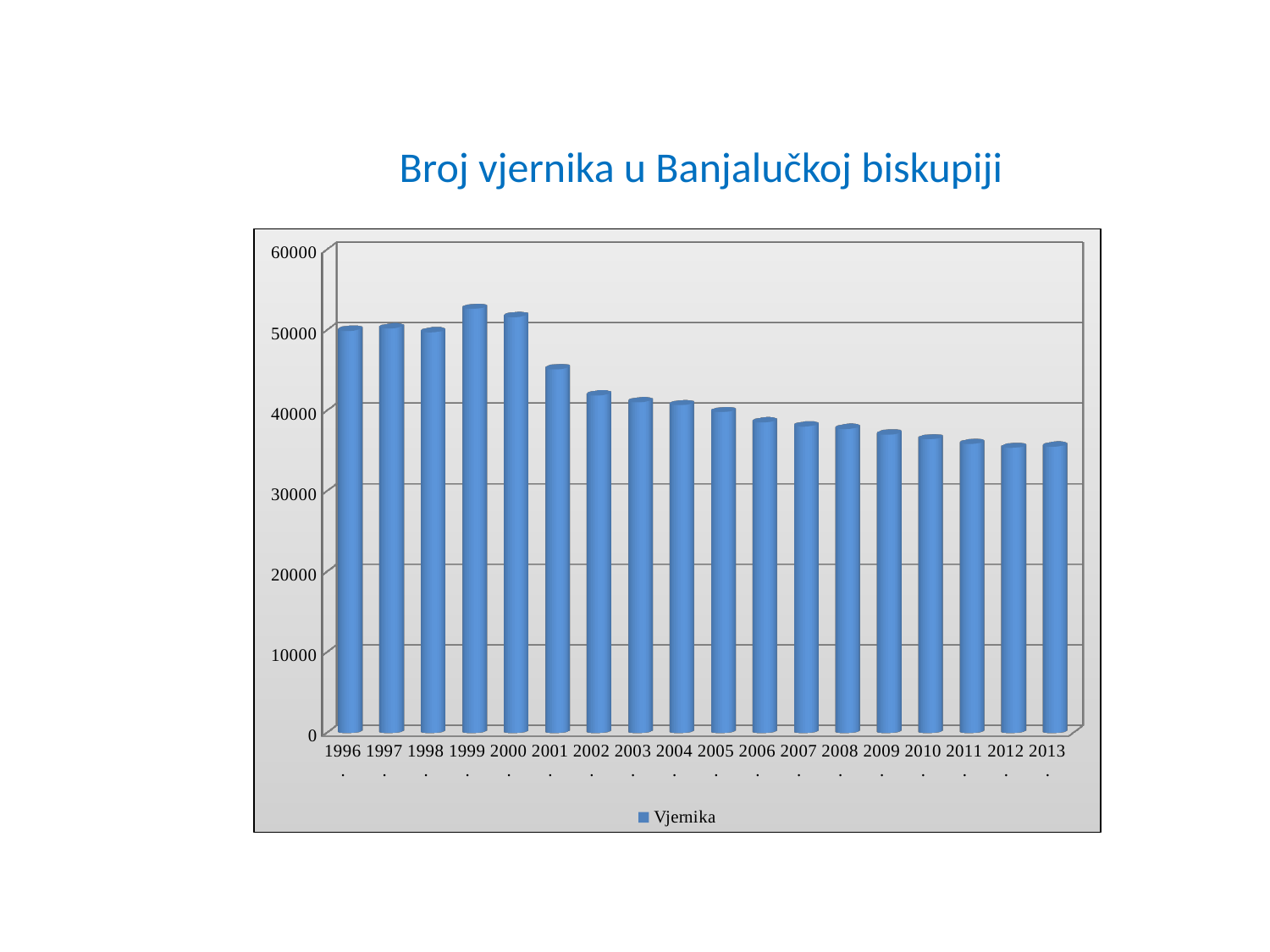
What kind of chart is shown on the slide? bar chart What is the title of the chart? Broj vjernika u Banjalučkoj biskupiji Is the value for 2010 greater or less than 40000? less Is the value for 2001 greater or less than 40000? greater Is the value for 1999 greater or less than 50000? greater What is the name of the series shown in the legend? Vjernika Which year has the highest number of Vjernika? 1999 Which is larger, the value for 2001 or the value for 2006? 2001 How many years are shown on the x axis? 18 How many series does the legend list? 1 Do the values generally rise or fall from 1996 to 2013? fall